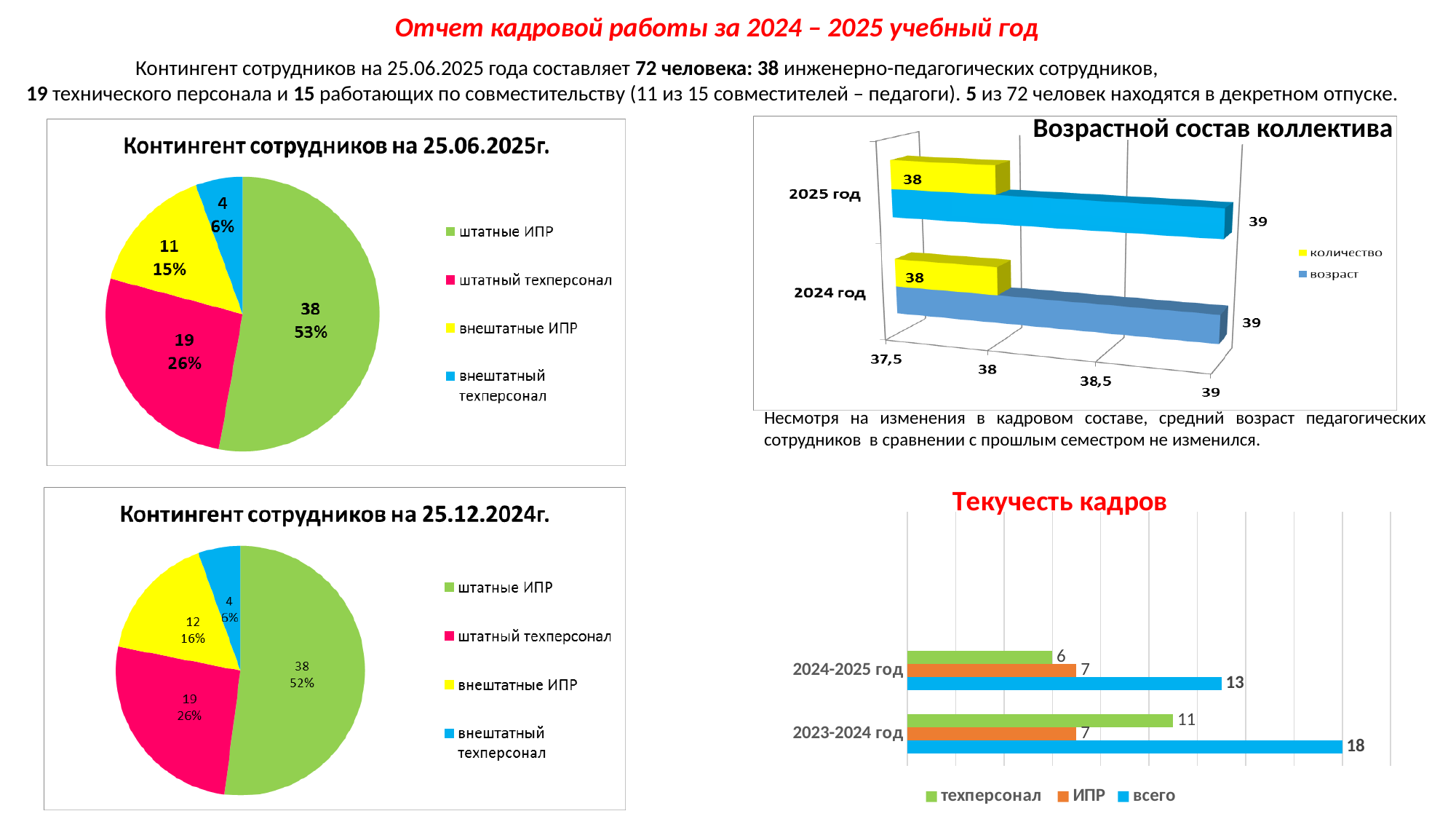
In the chart 'Контингент сотрудников на 25.12.2024г.', what is the value for внештатные ИПР? 12 How many categories does the legend of the chart 'Контингент сотрудников на 25.12.2024г.' list? 4 In the chart 'Текучесть кадров', which is larger: всего for 2023-2024 год or всего for 2024-2025 год? 2023-2024 год In the chart 'Контингент сотрудников на 25.06.2025г.', which category is the smallest? внештатный техперсонал What kind of chart is 'Контингент сотрудников на 25.06.2025г.'? pie chart How many series does the legend of the chart 'Возрастной состав коллектива' list? 2 In the chart 'Контингент сотрудников на 25.06.2025г.', what share of the pie is штатный техперсонал? 26% In the chart 'Возрастной состав коллектива', what is the value of возраст for 2025 год? 39 In the chart 'Контингент сотрудников на 25.06.2025г.', what is the value for штатные ИПР? 38 In the chart 'Контингент сотрудников на 25.12.2024г.', what share of the pie is штатные ИПР? 52% In the chart 'Текучесть кадров', what is the value of всего for 2023-2024 год? 18 In the chart 'Текучесть кадров', what is the difference between техперсонал for 2023-2024 год and for 2024-2025 год? 5